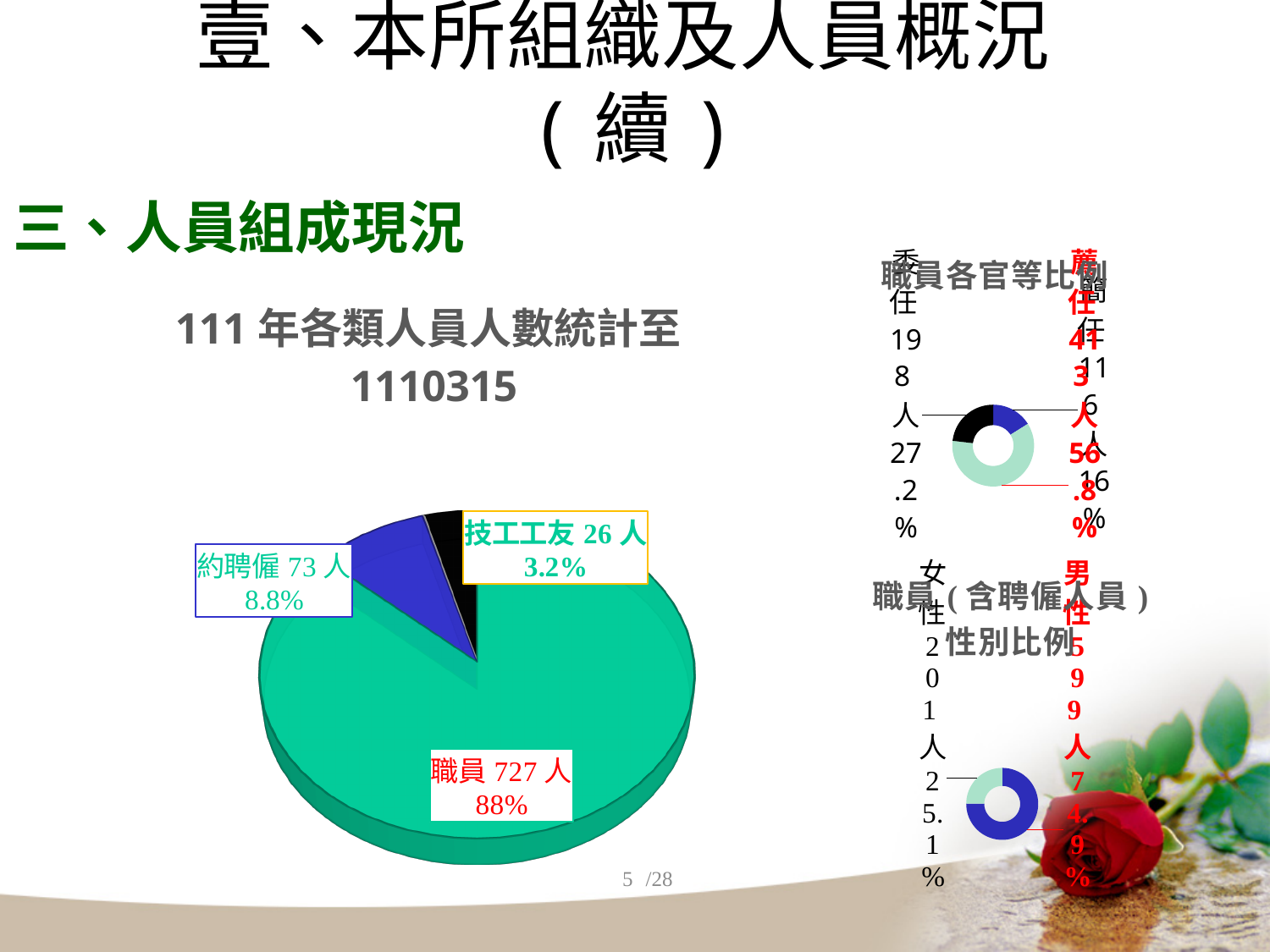
What kind of chart is the large chart on the left of the slide? Pie chart In the chart titled 職員各官等比例, what percentage share is 委任? 27.2% In the pie chart titled 111年各類人員人數統計至1110315, how many people are in the 職員 category? 727 人 In the pie chart titled 111年各類人員人數統計至1110315, what percentage share does 約聘僱 have? 8.8% In the pie chart titled 111年各類人員人數統計至1110315, which category has the largest share? 職員 In the pie chart titled 111年各類人員人數統計至1110315, which category has the smallest share? 技工工友 In the pie chart titled 111年各類人員人數統計至1110315, how many categories are shown? 3 In the chart titled 職員(含聘僱人員)性別比例, how many people are 女性? 201 人 In the chart titled 職員(含聘僱人員)性別比例, what percentage share is 男性? 74.9% In the pie chart titled 111年各類人員人數統計至1110315, how many people are 技工工友? 26 人 In the pie chart titled 111年各類人員人數統計至1110315, which is larger, 約聘僱 or 技工工友? 約聘僱 In the pie chart titled 111年各類人員人數統計至1110315, what is the difference in headcount between 約聘僱 and 技工工友? 47 人